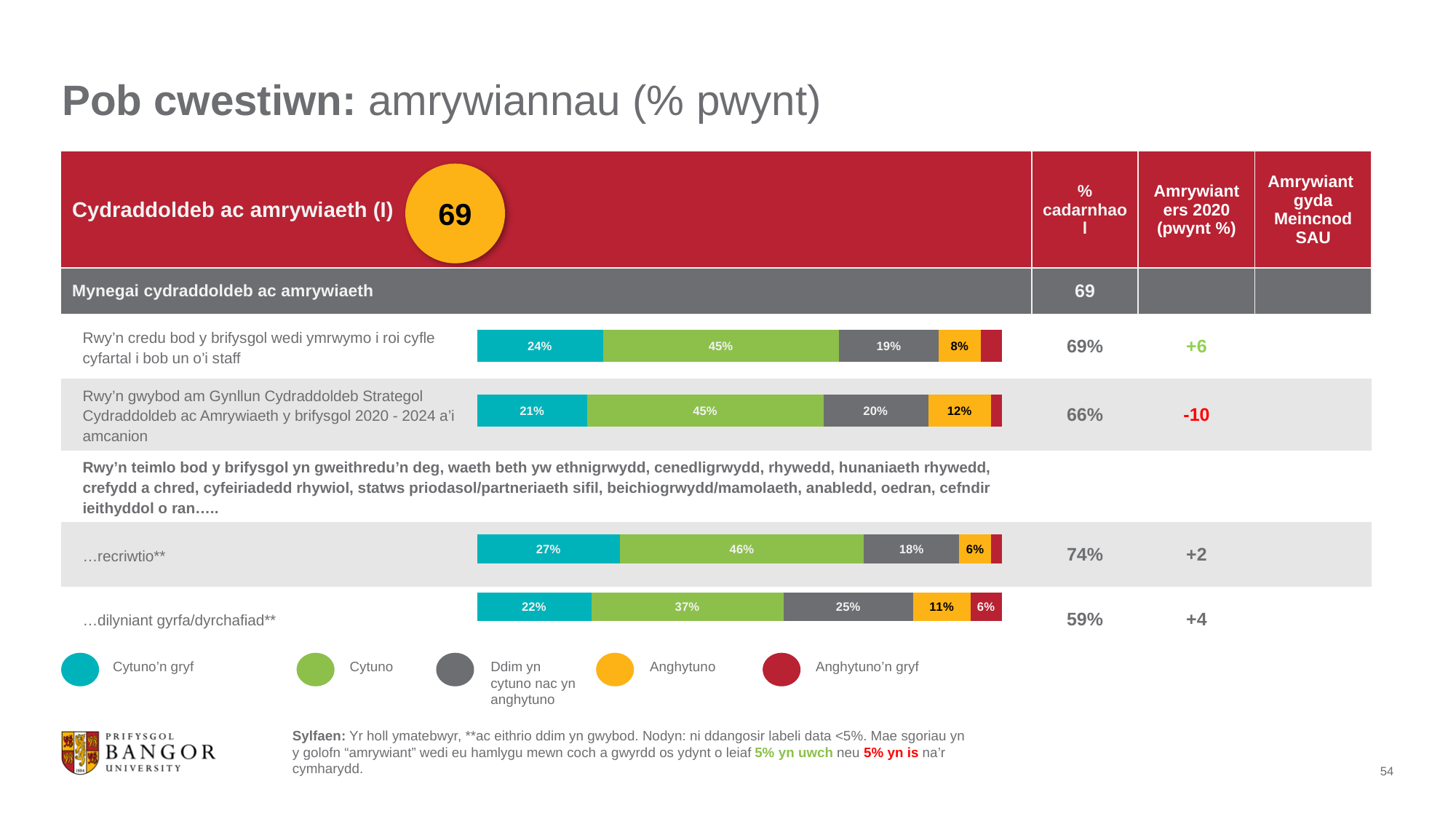
Which statement has the lowest Cytuno value? …dilyniant gyrfa/dyrchafiad** What kind of chart is used to show the responses for each statement? stacked bar chart How many statements have a bar plotted on the slide? 4 What colour represents Anghytuno'n gryf in the legend? red Which is larger: the Anghytuno value for "…recriwtio**" or for "…dilyniant gyrfa/dyrchafiad**"? …dilyniant gyrfa/dyrchafiad** What is the difference between the Ddim yn cytuno nac yn anghytuno values for "…dilyniant gyrfa/dyrchafiad**" and "…recriwtio**"? 7% What is the Anghytuno value for the "Rwy'n gwybod am Gynllun Cydraddoldeb Strategol…" bar? 12% What is the Ddim yn cytuno nac yn anghytuno value for the "Rwy'n credu bod y brifysgol wedi ymrwymo i roi cyfle cyfartal i bob un o'i staff" bar? 19% Which statement has the highest Cytuno'n gryf value? …recriwtio** What is the Cytuno value for the "…dilyniant gyrfa/dyrchafiad**" bar? 37% How many series does the legend list? 5 What is the Cytuno'n gryf value for the "…recriwtio**" bar? 27%